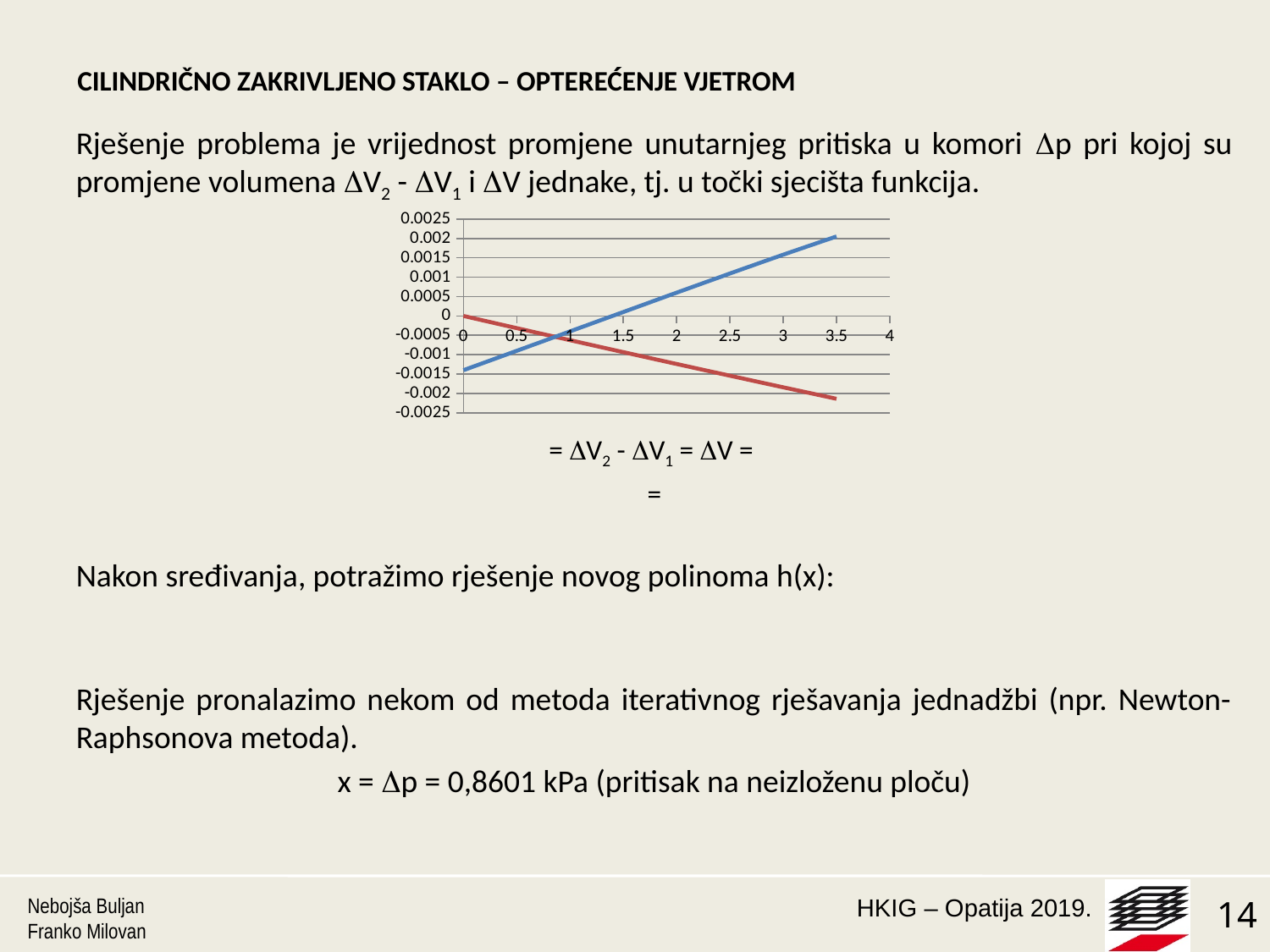
Is the value of the blue line at x = 3.5 greater or less than 0.001? greater Does the blue line rise or fall as x increases? rises How many lines are plotted on the chart? 2 At x = 0, which line has the higher value, the blue or the red? red What is the largest value labelled on the chart's x axis? 4 Is the value of the blue line at x = 0 greater or less than 0? less Does the red line rise or fall as x increases? falls Is the value of the red line at x = 3.5 greater or less than -0.001? less At x = 3, which line has the higher value, the blue or the red? blue What is the highest value shown on the chart's y axis? 0.0025 What kind of chart is shown on the slide? line chart